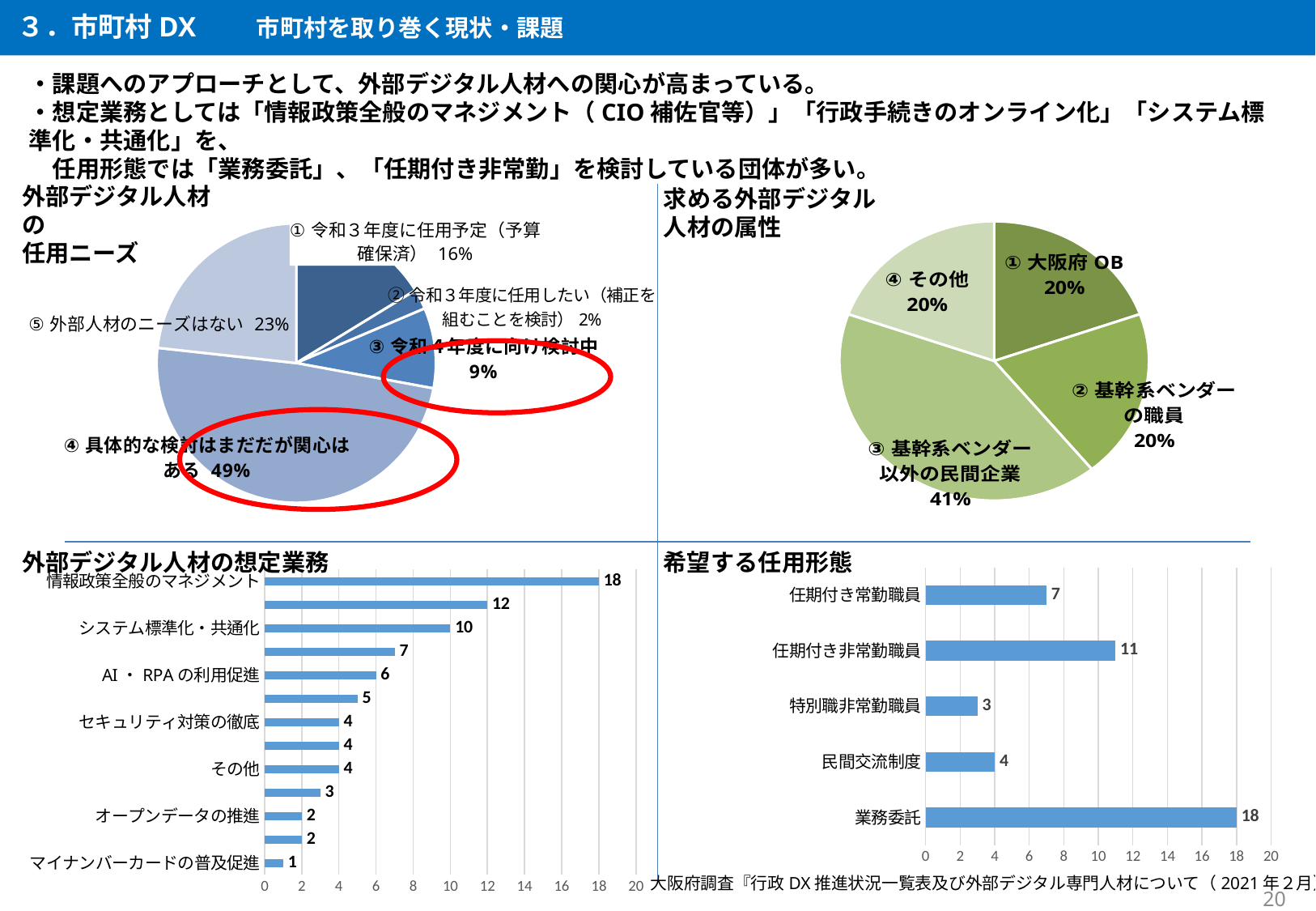
In the chart titled 外部デジタル人材の想定業務, what is the value for システム標準化・共通化? 10 In the pie chart titled 求める外部デジタル人材の属性, what share is ③ 基幹系ベンダー以外の民間企業? 41% In the pie chart titled 求める外部デジタル人材の属性, what share is ① 大阪府OB? 20% In the chart titled 希望する任用形態, what is the difference between 任期付き非常勤職員 and 任期付き常勤職員? 4 In the pie chart titled 外部デジタル人材の任用ニーズ, what share is ⑤ 外部人材のニーズはない? 23% In the pie chart titled 求める外部デジタル人材の属性, how many slices are there? 4 In the pie chart titled 外部デジタル人材の任用ニーズ, what is the difference between the shares of ① 令和3年度に任用予定 and ③ 令和4年度に向け検討中? 7% In the chart titled 希望する任用形態, what is the value for 業務委託? 18 In the chart titled 希望する任用形態, which category has the lowest value? 特別職非常勤職員 In the pie chart titled 外部デジタル人材の任用ニーズ, which category has the smallest share? ② 令和3年度に任用したい（補正を組むことを検討） What kind of chart is the chart titled 希望する任用形態? bar chart